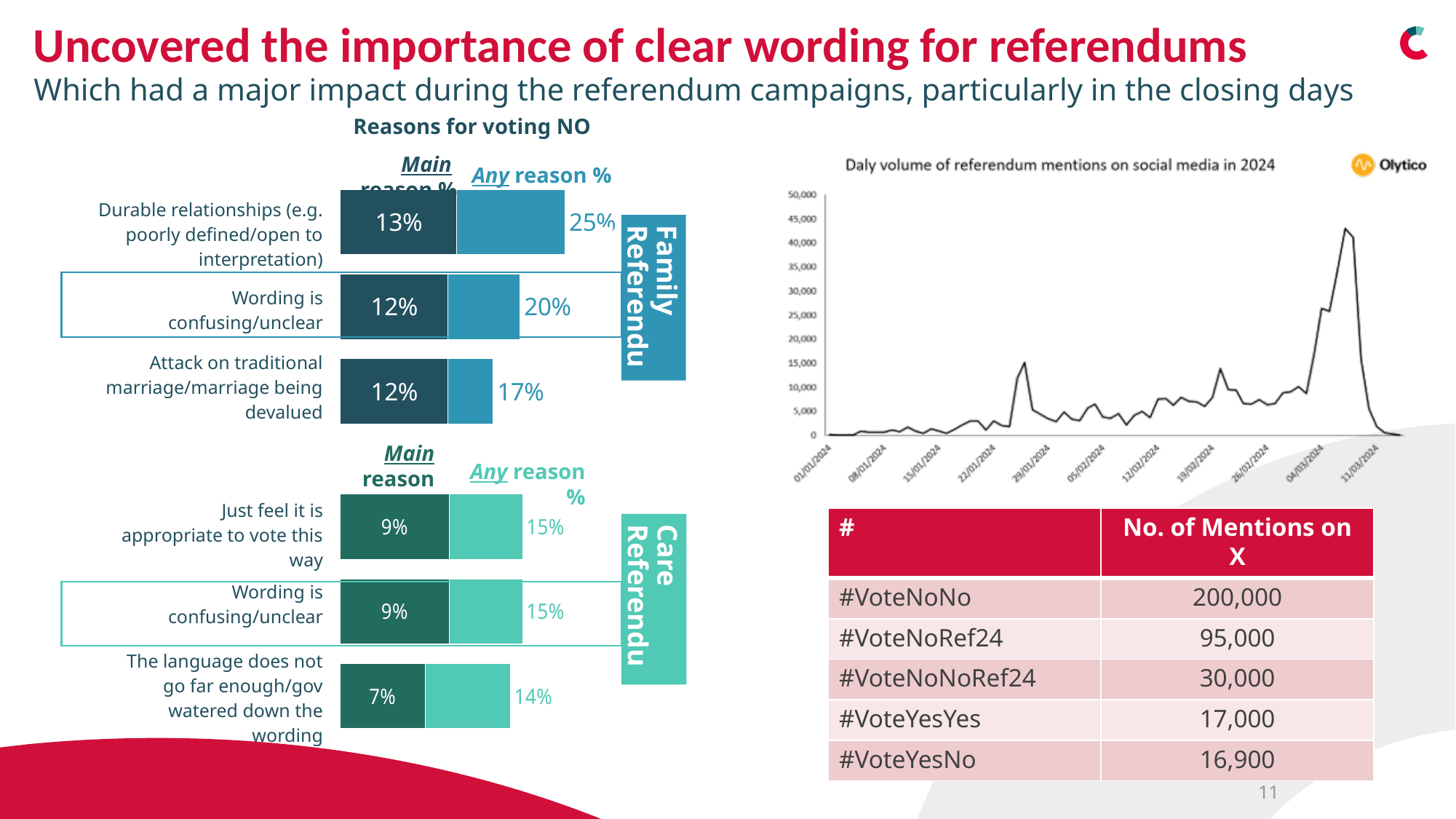
In the Family Referendum chart, what is the Any reason % for 'Durable relationships (e.g. poorly defined/open to interpretation)'? 25% In the Care Referendum chart, what is the Main reason % for 'Just feel it is appropriate to vote this way'? 9% In the Family Referendum chart, which reason has the highest Any reason %? Durable relationships (e.g. poorly defined/open to interpretation) In the Family Referendum chart, what is the difference between the Any reason % and the Main reason % for 'Durable relationships'? 12 percentage points In the Care Referendum chart, what is the Any reason % for 'The language does not go far enough/gov watered down the wording'? 14% In the Care Referendum chart, which reason has the lowest Main reason %? The language does not go far enough/gov watered down the wording Is the Any reason % for 'Wording is confusing/unclear' larger in the Family Referendum chart or the Care Referendum chart? Family Referendum In the Family Referendum chart, what is the Main reason % for 'Wording is confusing/unclear'? 12% How many reasons are listed in the Family Referendum chart? 3 What kind of chart is 'Daly volume of referendum mentions on social media in 2024'? Line chart In the 'Daly volume of referendum mentions on social media in 2024' chart, is the highest peak greater or less than 40,000? greater How many series does the Family Referendum chart show? 2